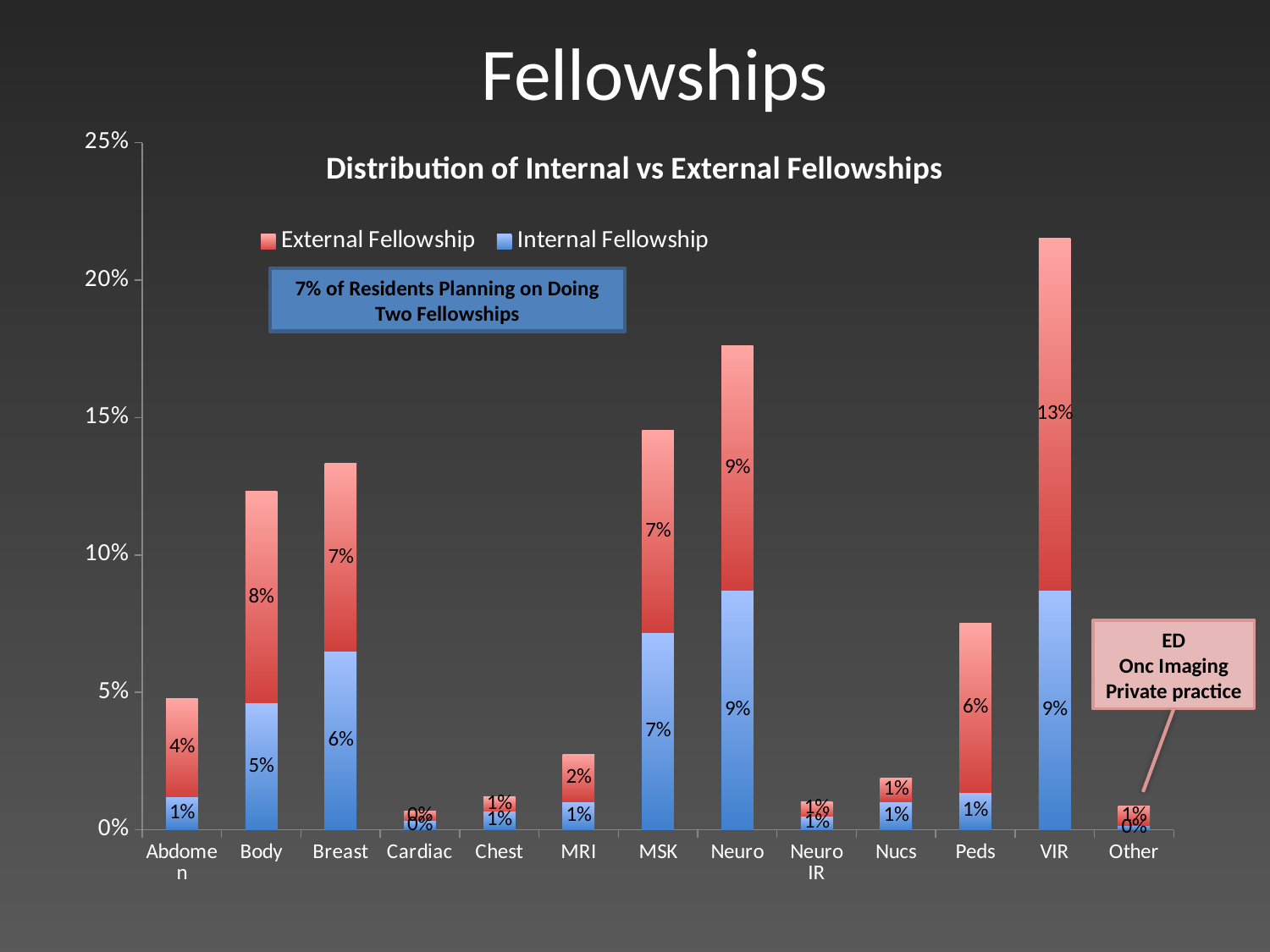
What is the External Fellowship value for VIR? 13% What is the difference between the External Fellowship values for VIR and Peds? 7% What is the Internal Fellowship value for MSK? 7% How many series does the legend list? 2 What kind of chart is shown on the slide? Stacked bar chart What is the Internal Fellowship value for Body? 5% Which is larger, the External Fellowship value for Body or for Breast? Body What is the External Fellowship value for Peds? 6% Which category has the tallest stacked bar overall? VIR How many fellowship categories are shown on the x axis? 13 Is the total stacked bar for Neuro greater or less than 15%? greater Which category has the highest External Fellowship value? VIR